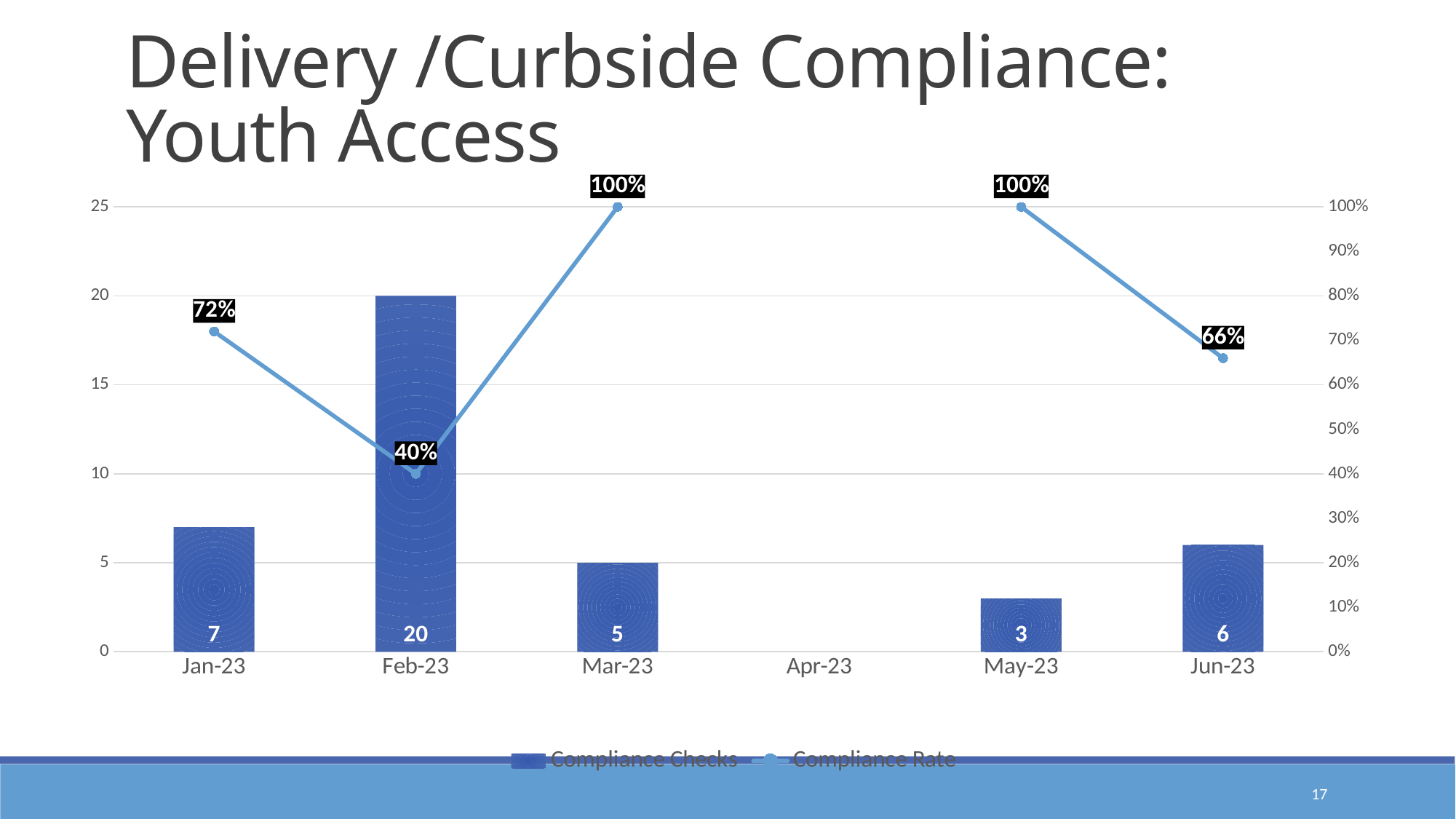
How many Compliance Checks were there in Feb-23? 20 What is the difference in Compliance Checks between Feb-23 and Mar-23? 15 What was the Compliance Rate in Jan-23? 72% How many Compliance Checks were there in May-23? 3 Does the Compliance Rate rise or fall from May-23 to Jun-23? Fall What kind of chart is shown on the slide? Combined bar and line chart Which month had the highest number of Compliance Checks? Feb-23 Which month on the x axis has no bar or data point plotted? Apr-23 What was the Compliance Rate in Jun-23? 66% Which month had the lowest Compliance Rate? Feb-23 How many series does the legend list? 2 Which month had more Compliance Checks, Jan-23 or Jun-23? Jan-23